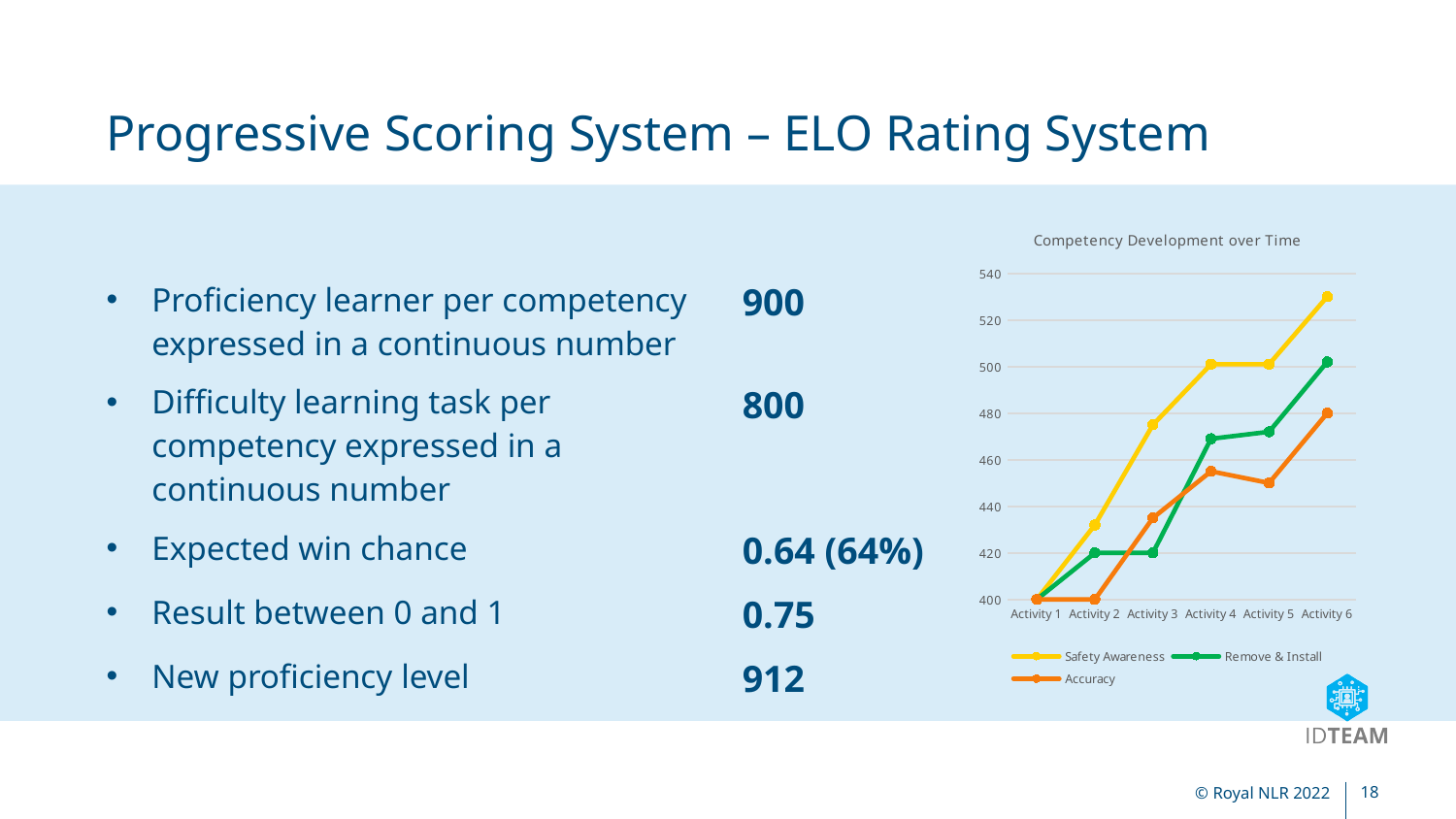
Do the Safety Awareness values rise or fall from Activity 1 to Activity 6? rise Is the value for Remove & Install at Activity 4 greater or less than 460? greater Which series has the highest value at Activity 6? Safety Awareness How many series does the chart's legend list? 3 What is the title of the chart? Competency Development over Time Is the value for Safety Awareness at Activity 6 greater or less than 520? greater Is the value for Accuracy at Activity 6 greater or less than 500? less What is the value for Safety Awareness at Activity 1? 400 How many activities are shown along the x axis of the chart? 6 At Activity 4, which is larger: Safety Awareness or Accuracy? Safety Awareness Which series has the lowest value at Activity 3? Remove & Install What kind of chart is shown on the slide? line chart